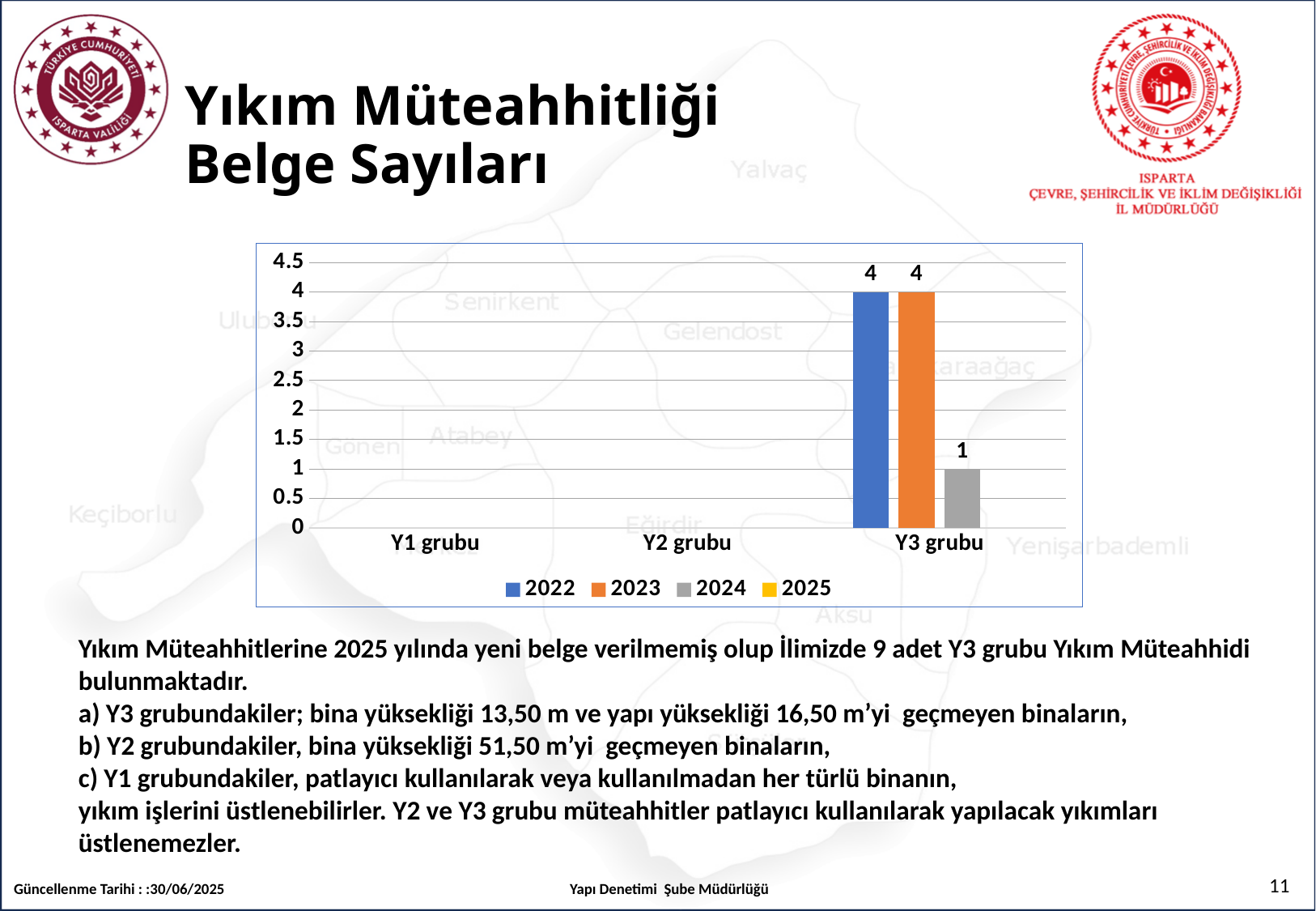
Which category is the only one with visible bars? Y3 grubu Is the value for 2024 in Y3 grubu greater or less than 2? less Which series has the lowest visible bar in the Y3 grubu category? 2024 What is the value for 2024 in the Y3 grubu category? 1 What is the value for 2023 in the Y3 grubu category? 4 How many categories are shown on the x axis? 3 What is the value for 2022 in the Y3 grubu category? 4 Is the 2022 value for Y3 grubu larger or smaller than the 2024 value for Y3 grubu? larger What is the difference between the 2023 value and the 2024 value for Y3 grubu? 3 Which legend entry is shown in yellow? 2025 How many series does the legend list? 4 What kind of chart is shown on the slide? bar chart